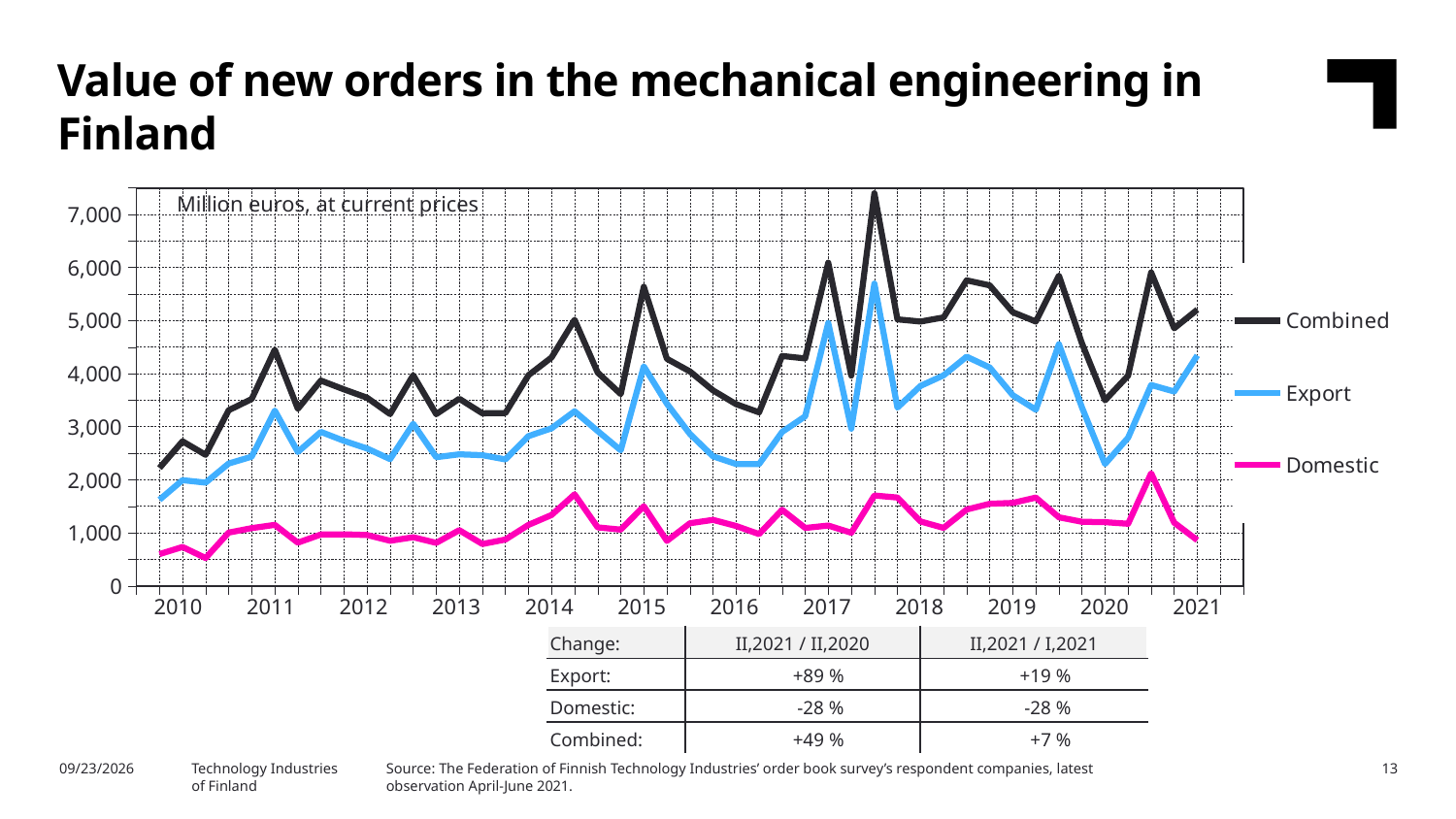
Which series are listed in the legend? Combined, Export, Domestic Is the peak value of the Combined series in 2017 greater or less than 7,000? greater Which series has the lowest values throughout the chart? Domestic What unit is stated for the values in the chart? Million euros, at current prices Which is larger in 2015, the Export series or the Domestic series? Export Is the value for Domestic at the start of 2010 greater or less than 1,000? less How many series does the legend list? 3 What kind of chart is shown on the slide? line chart How many year labels are shown on the x axis? 12 Is the peak value of the Export series in 2017 greater or less than 5,000? greater Does the Combined series rise or fall from 2010 to 2011? rise Which series has the highest values throughout the chart? Combined